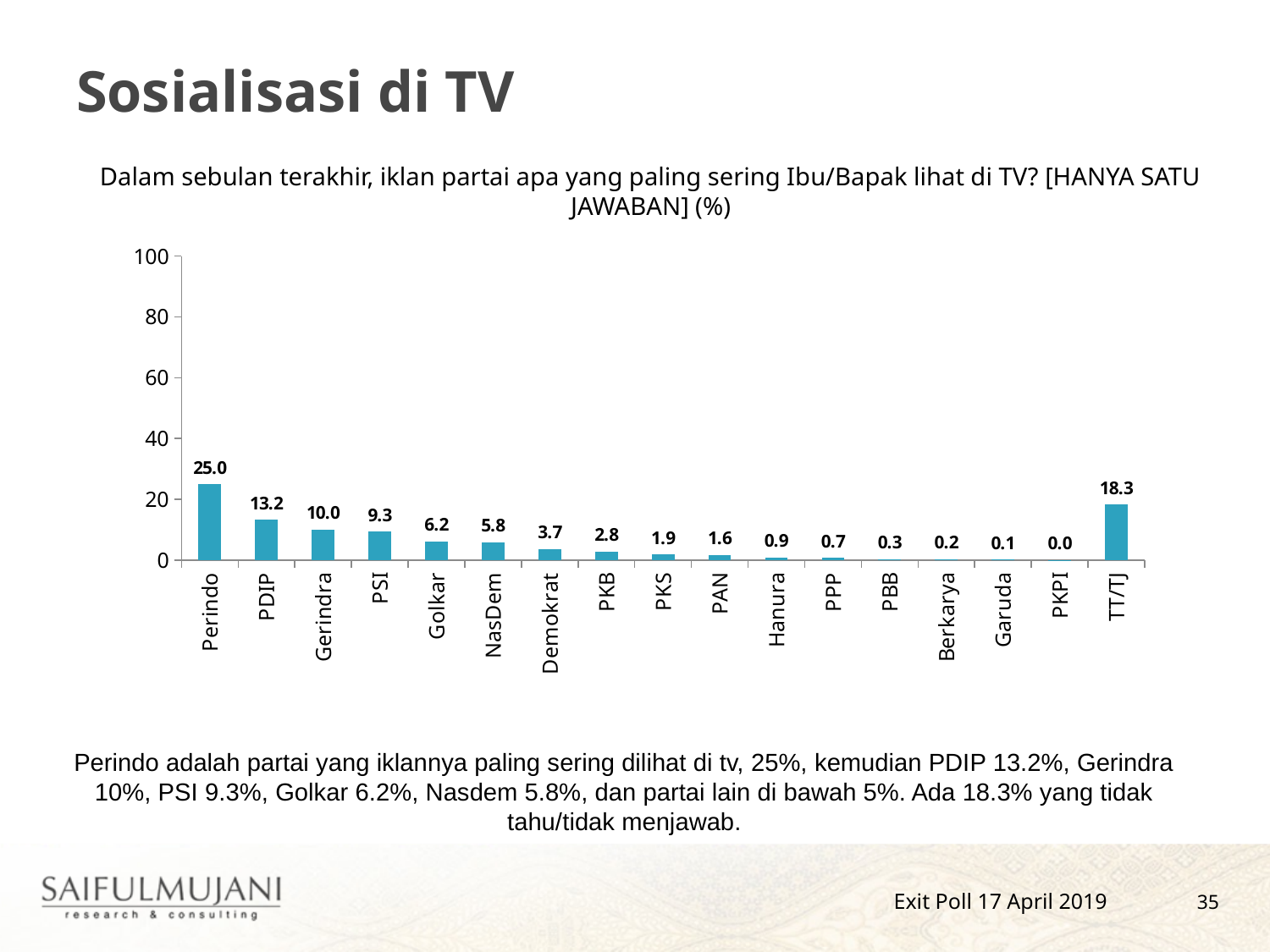
How many categories are shown on the x axis? 17 Which category has the highest value? Perindo What is the difference between the values for Perindo and PDIP? 11.8 Is the value for Gerindra greater or less than 20? less What is the value for Perindo? 25.0 What is the value for NasDem? 5.8 Which category has the lowest value? PKPI What kind of chart is shown on the slide? bar chart What is the value for TT/TJ? 18.3 What is the maximum value shown on the y axis? 100 Which is larger, the value for Golkar or the value for NasDem? Golkar What is the value for PDIP? 13.2